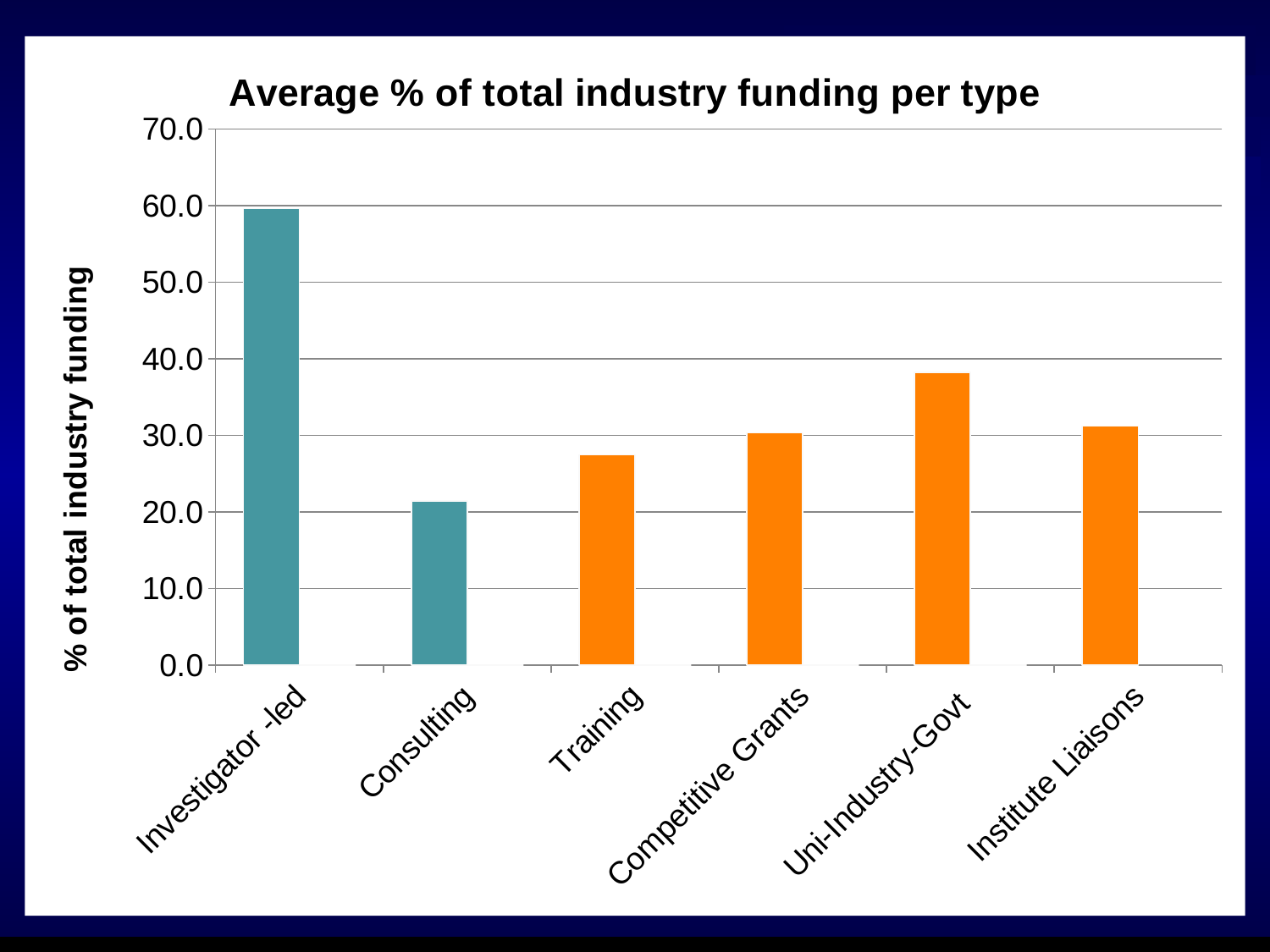
Which category has the lowest average % of total industry funding? Consulting Which is larger, the value for Uni-Industry-Govt or the value for Institute Liaisons? Uni-Industry-Govt What is the title of the chart? Average % of total industry funding per type Is the value for Uni-Industry-Govt greater or less than 40.0? less Is the value for Investigator -led greater or less than 50.0? greater What is the label on the y axis of the chart? % of total industry funding What type of chart is shown on the slide? bar chart How many categories are shown on the x axis of the chart? 6 Which category has the highest average % of total industry funding? Investigator -led Is the value for Consulting greater or less than 30.0? less Which is larger, the value for Consulting or the value for Training? Training